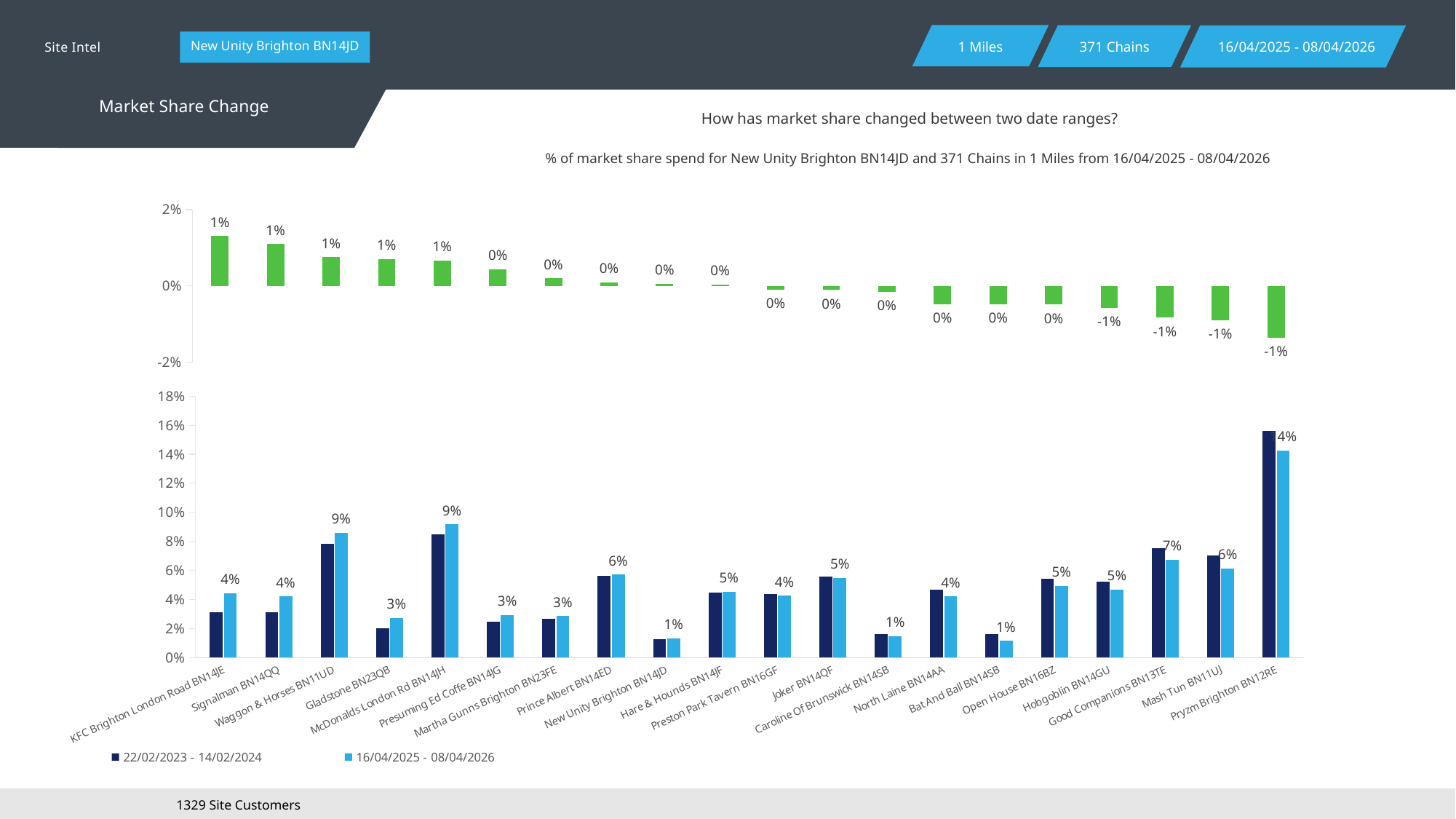
What kind of chart is the bottom chart? bar chart On the bottom chart, what are the two legend entries? 22/02/2023 - 14/02/2024 and 16/04/2025 - 08/04/2026 On the bottom chart, what is the value for Pryzm Brighton BN12RE in the 16/04/2025 - 08/04/2026 series? 14% On the bottom chart, how many categories are shown on the x axis? 20 On the bottom chart, is the value for Pryzm Brighton BN12RE in the 22/02/2023 - 14/02/2024 series greater or less than 14%? greater On the bottom chart, what is the difference between the 16/04/2025 - 08/04/2026 values for Pryzm Brighton BN12RE and Good Companions BN13TE? 7% On the bottom chart, how many series does the legend list? 2 On the bottom chart, which category has the highest value in the 16/04/2025 - 08/04/2026 series? Pryzm Brighton BN12RE On the bottom chart, what is the value for Good Companions BN13TE in the 16/04/2025 - 08/04/2026 series? 7% On the bottom chart, what is the value for Waggon & Horses BN11UD in the 16/04/2025 - 08/04/2026 series? 9% On the bottom chart, for Pryzm Brighton BN12RE, which series has the larger value: 22/02/2023 - 14/02/2024 or 16/04/2025 - 08/04/2026? 22/02/2023 - 14/02/2024 On the top chart, what is the value of the rightmost bar? -1%